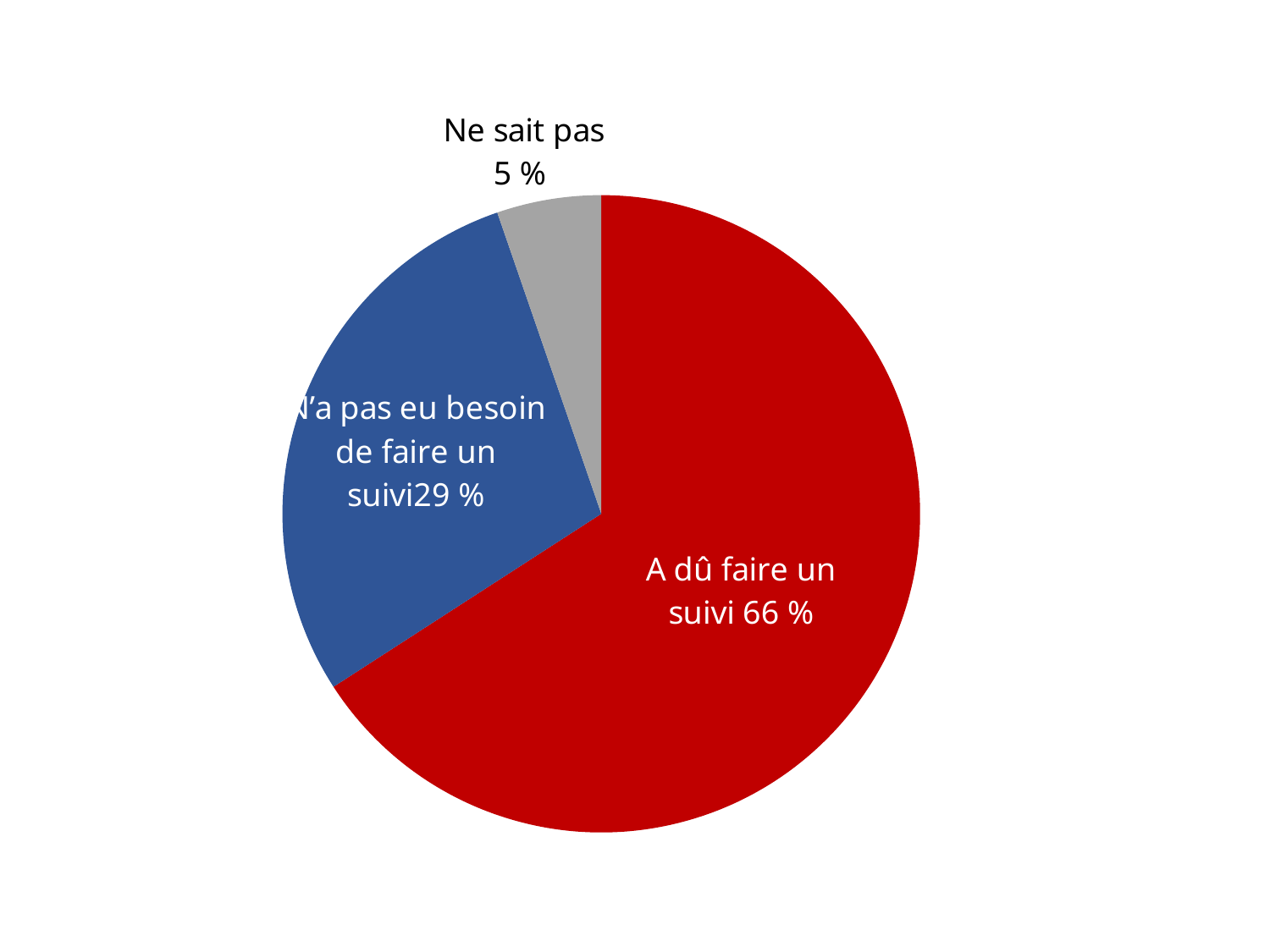
What kind of chart is shown on the slide? pie chart What colour is the slice for "Ne sait pas"? grey Which is larger: the share for "N'a pas eu besoin de faire un suivi" or the share for "Ne sait pas"? N'a pas eu besoin de faire un suivi How many slices does the pie chart have? 3 What share of the pie is labelled "N'a pas eu besoin de faire un suivi"? 29 % Which slice of the pie is the smallest? Ne sait pas Which slice of the pie is the largest? A dû faire un suivi What share of the pie is labelled "Ne sait pas"? 5 % What is the difference in percentage points between "N'a pas eu besoin de faire un suivi" and "Ne sait pas"? 24 % What share of the pie is labelled "A dû faire un suivi"? 66 % What colour is the slice for "A dû faire un suivi"? red What is the difference in percentage points between "A dû faire un suivi" and "N'a pas eu besoin de faire un suivi"? 37 %